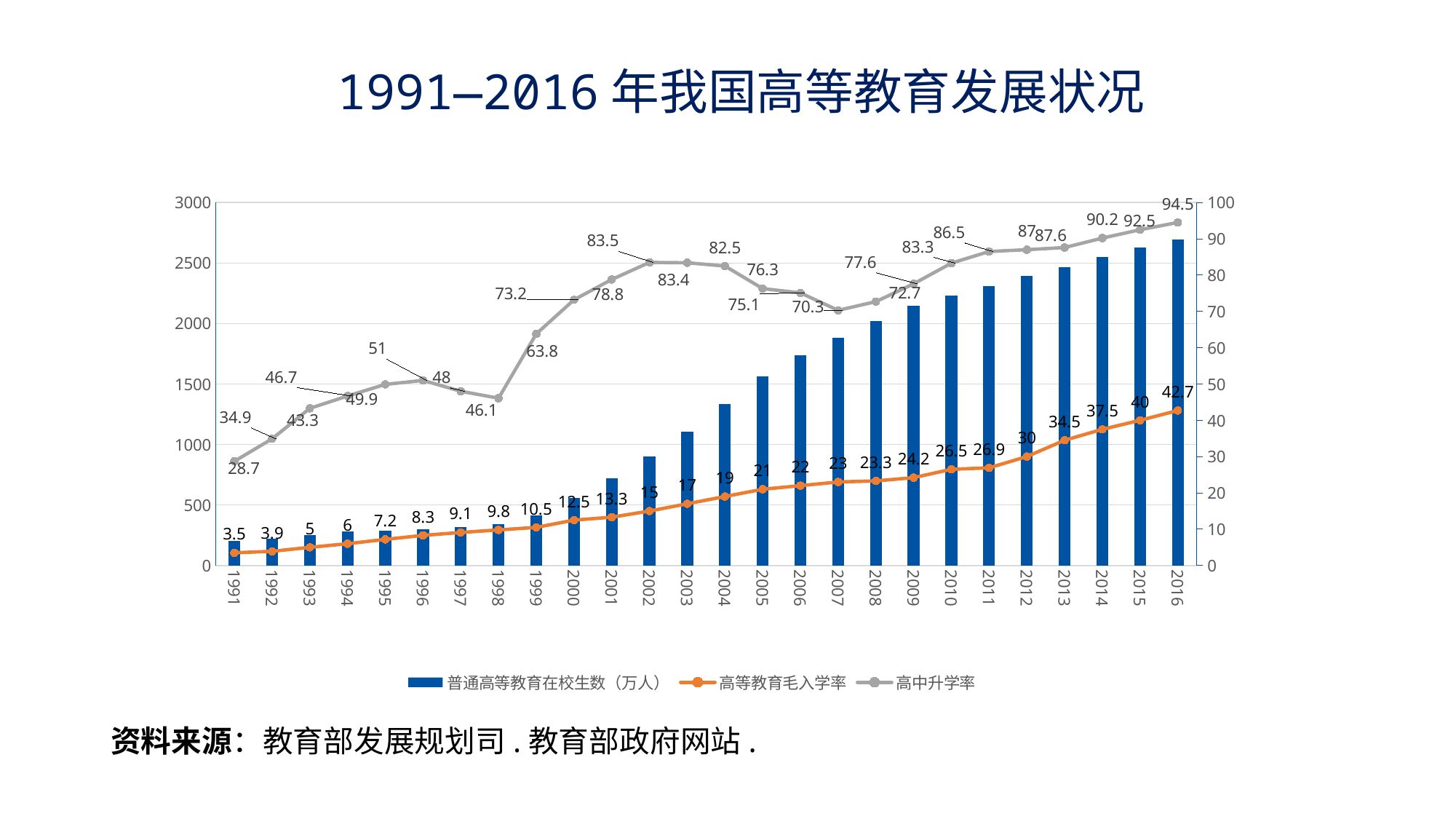
What is the 高中升学率 value for 2010? 83.3 What is the 高中升学率 value for 1991? 28.7 How many series does the legend list? 3 What kind of chart is shown on the slide? A combined bar and line chart How many years are shown on the x axis? 26 What is the 高等教育毛入学率 value for 2016? 42.7 Does 高等教育毛入学率 generally rise or fall from 1991 to 2016? rise By how much did 高等教育毛入学率 increase from 1991 to 2016? 39.2 In which year is 高等教育毛入学率 lowest? 1991 Is the 普通高等教育在校生数（万人） bar for 2016 greater or less than 2500? greater In which year is 高中升学率 highest? 2016 Which year has the higher 高中升学率, 2002 or 2007? 2002